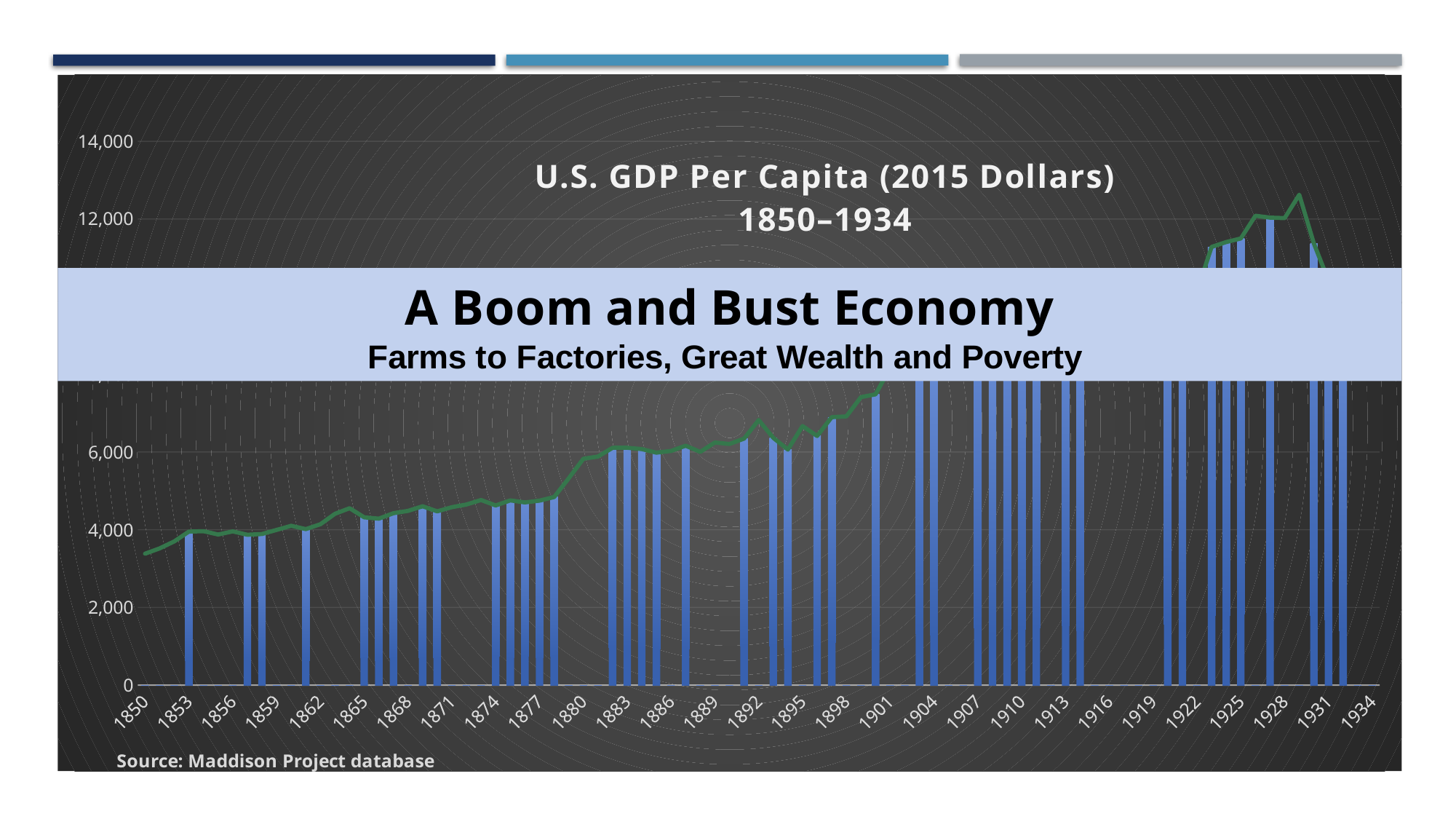
Is the value of the bar for 1865 greater or less than 4,000? greater Is the highest point of the green line greater or less than 12,000? greater Is the value of the bar for 1925 greater or less than 12,000? less Which bar is taller, 1853 or 1901? 1901 What is the title of the chart? U.S. GDP Per Capita (2015 Dollars) 1850–1934 Does the green line generally rise or fall from 1850 to 1928? rise Does the green line rise or fall between its peak near 1929 and 1934? fall What source is cited for the chart data? Maddison Project database What kind of chart is used for the green series? line chart What kind of chart is used for the blue series? bar chart